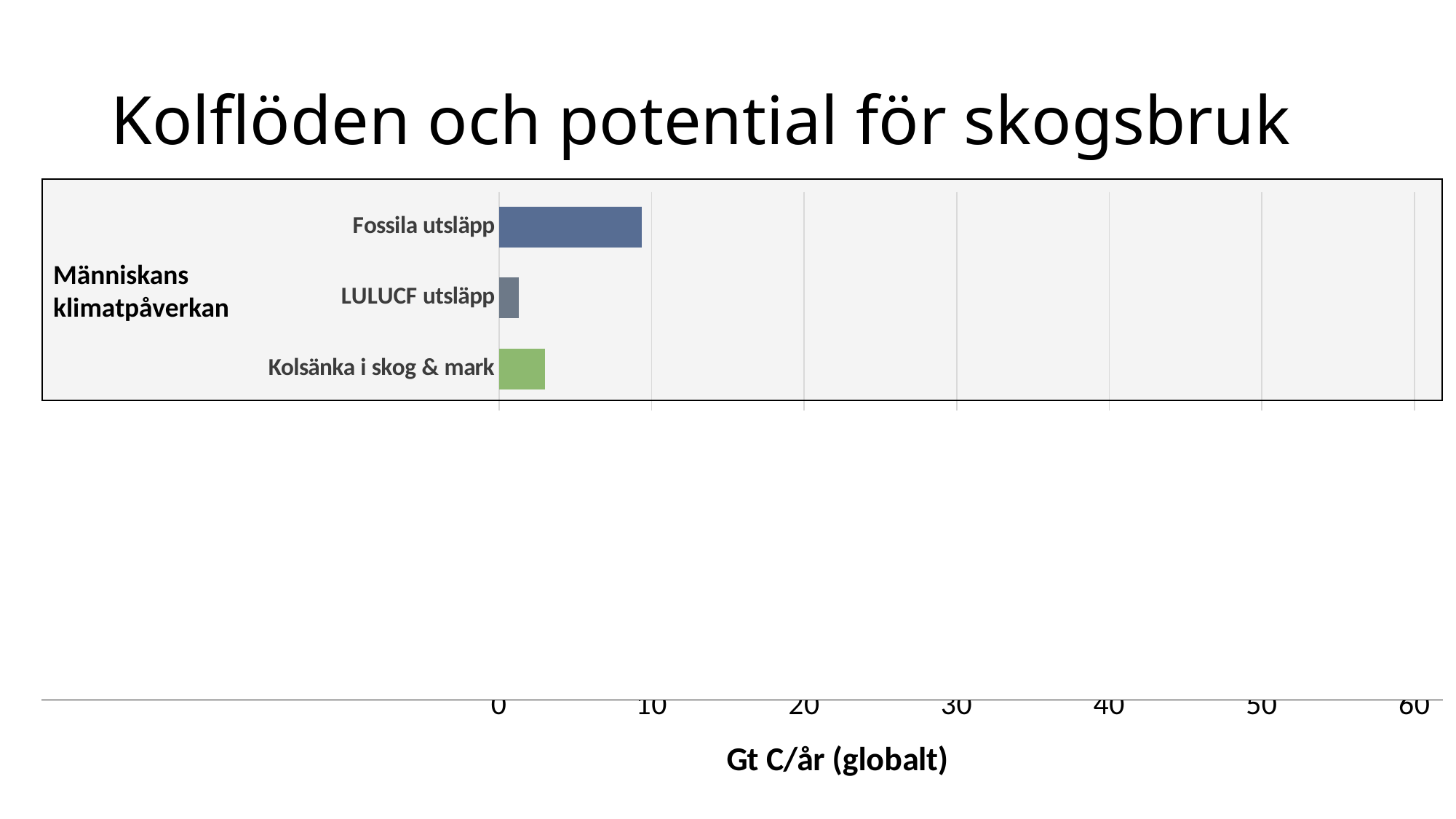
Which is larger, the value for Kolsänka i skog & mark or the value for LULUCF utsläpp? Kolsänka i skog & mark Is the value for Fossila utsläpp greater or less than 10? less Which category has the highest value in the chart? Fossila utsläpp What kind of chart is shown on the slide? bar chart Is the value for Kolsänka i skog & mark greater or less than 10? less What is the title of the x axis of the chart? Gt C/år (globalt) Which category has the lowest value in the chart? LULUCF utsläpp Which is larger, the value for Fossila utsläpp or the value for Kolsänka i skog & mark? Fossila utsläpp What is the title of the slide? Kolflöden och potential för skogsbruk How many categories (bars) are plotted in the chart? 3 Is the value for LULUCF utsläpp greater or less than 10? less